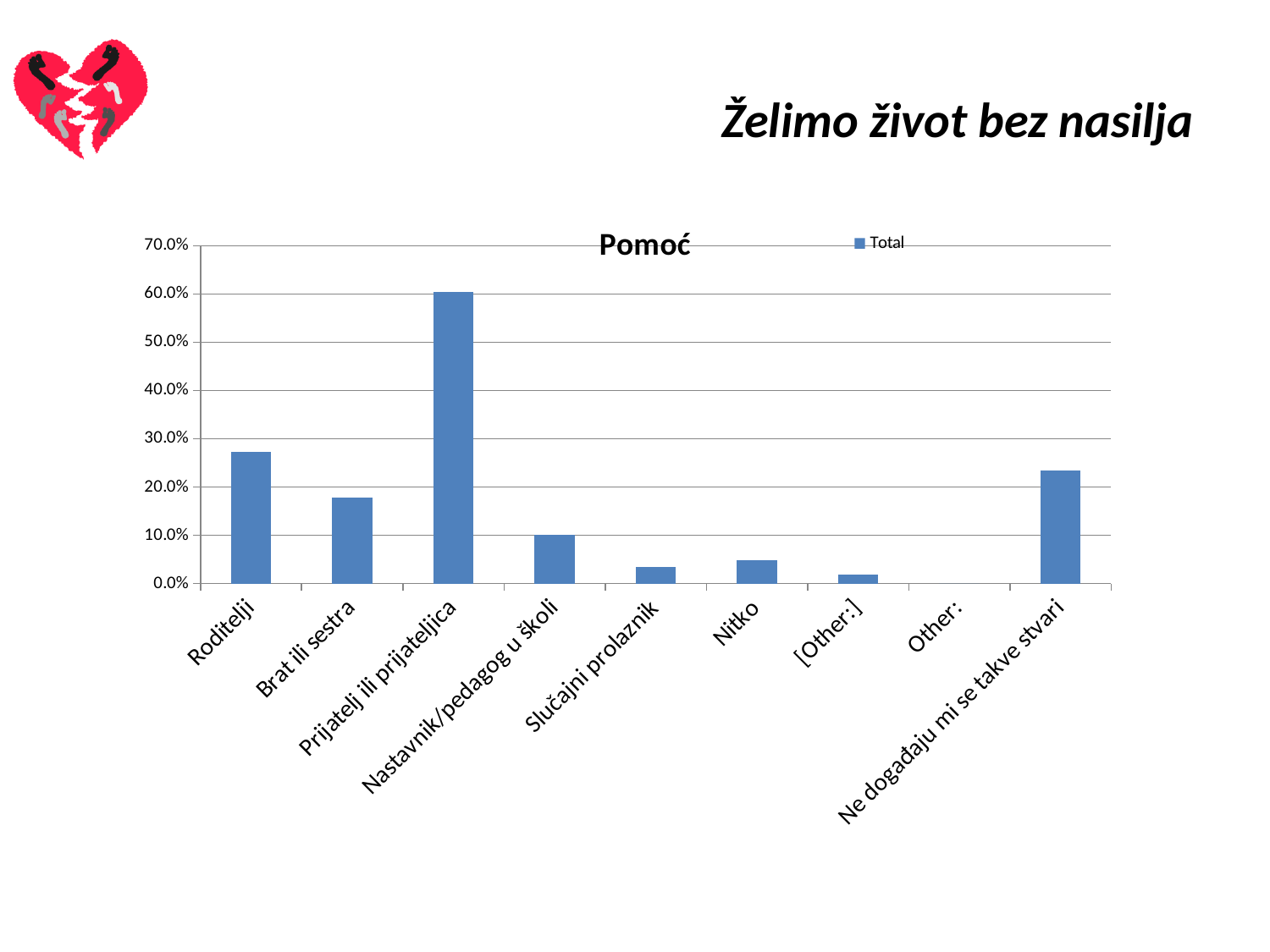
What is the name of the series shown in the legend? Total Is the value for Nitko greater or less than 10.0%? less What type of chart is shown on the slide? bar chart Which category has the lowest value? Other: Is the value for Prijatelj ili prijateljica greater or less than 50.0%? greater Which category has the highest value? Prijatelj ili prijateljica Which is larger, the value for Roditelji or the value for Ne događaju mi se takve stvari? Roditelji Is the value for Brat ili sestra greater or less than 20.0%? less What is the title of the chart? Pomoć How many categories are shown on the x axis? 9 How many series does the legend list? 1